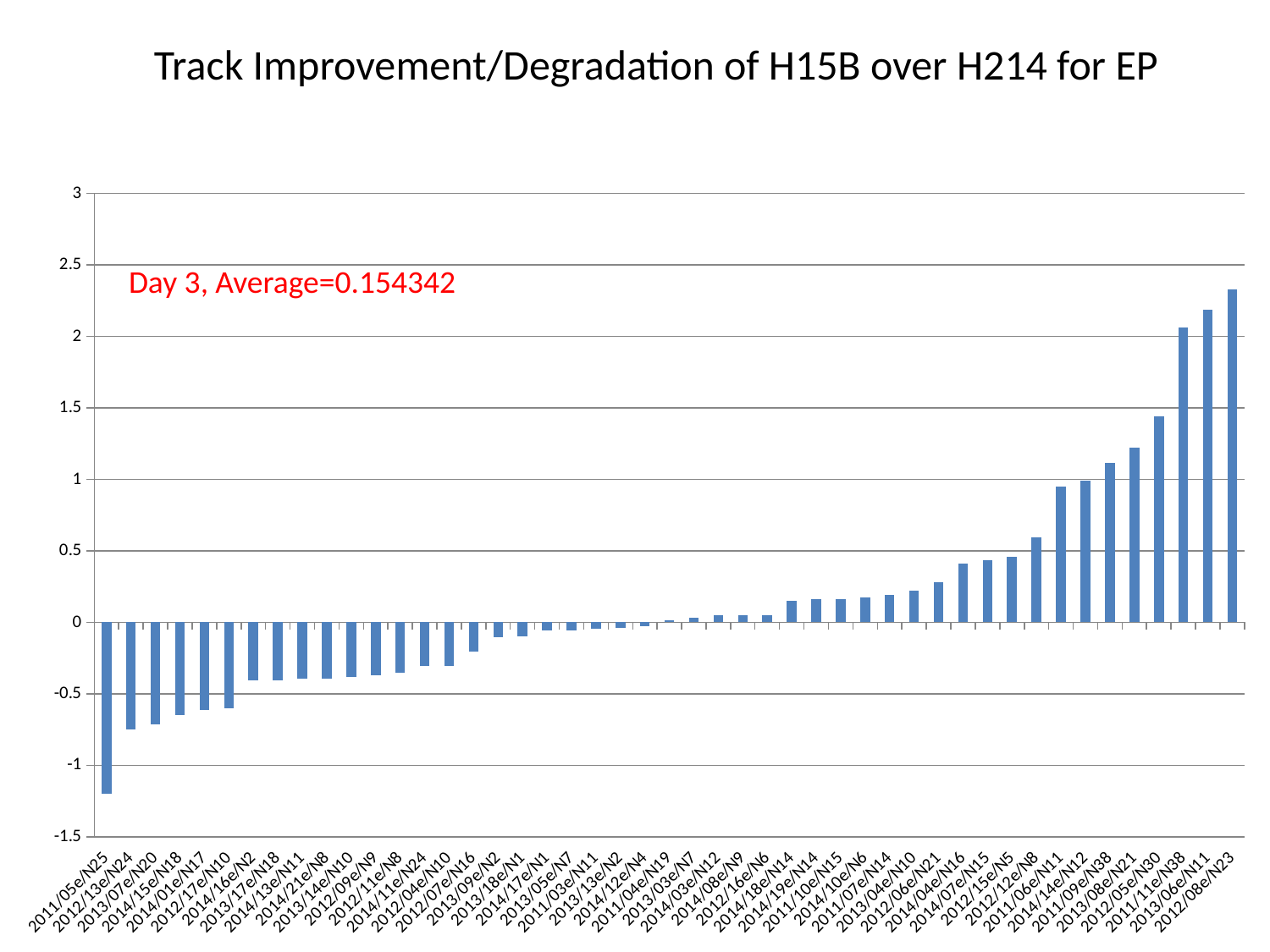
Which category has the highest value? 2012/08e/N23 What kind of chart is shown on the slide? bar chart Which is larger, the value for 2013/06e/N11 or the value for 2012/05e/N30? 2013/06e/N11 Is the value for 2012/08e/N23 greater or less than 2? greater What average value is stated in the red text on the chart? 0.154342 Is the value for 2012/13e/N24 greater or less than -0.5? less Do the bar values rise or fall from left to right along the x axis? rise Which category has the lowest value? 2011/05e/N25 Is the value for 2012/05e/N30 greater or less than 1.5? less What is the title of the chart? Track Improvement/Degradation of H15B over H214 for EP